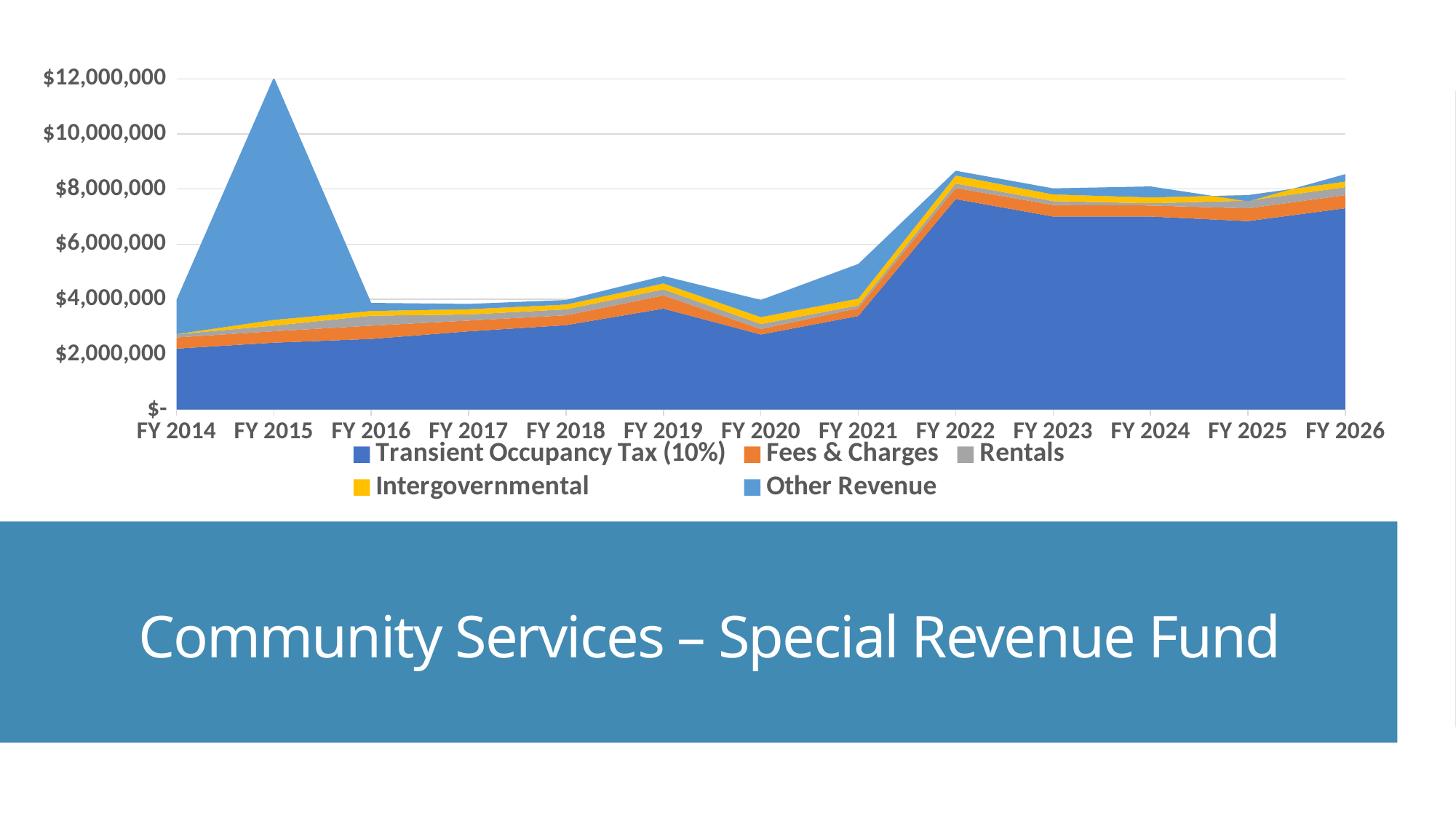
In which fiscal year is the total revenue highest? FY 2015 Is the Transient Occupancy Tax (10%) value for FY 2014 greater or less than $2,000,000? greater Is the total revenue for FY 2022 greater or less than $8,000,000? greater Which series is shown in yellow in the chart's legend? Intergovernmental How many fiscal years are shown along the x axis of the chart? 13 What kind of chart is shown on the slide? Stacked area chart Is the total revenue for FY 2015 greater or less than $10,000,000? greater How many series does the chart's legend list? 5 Does the Transient Occupancy Tax (10%) value rise or fall from FY 2014 to FY 2019? rise Which fiscal year has the larger total revenue, FY 2015 or FY 2022? FY 2015